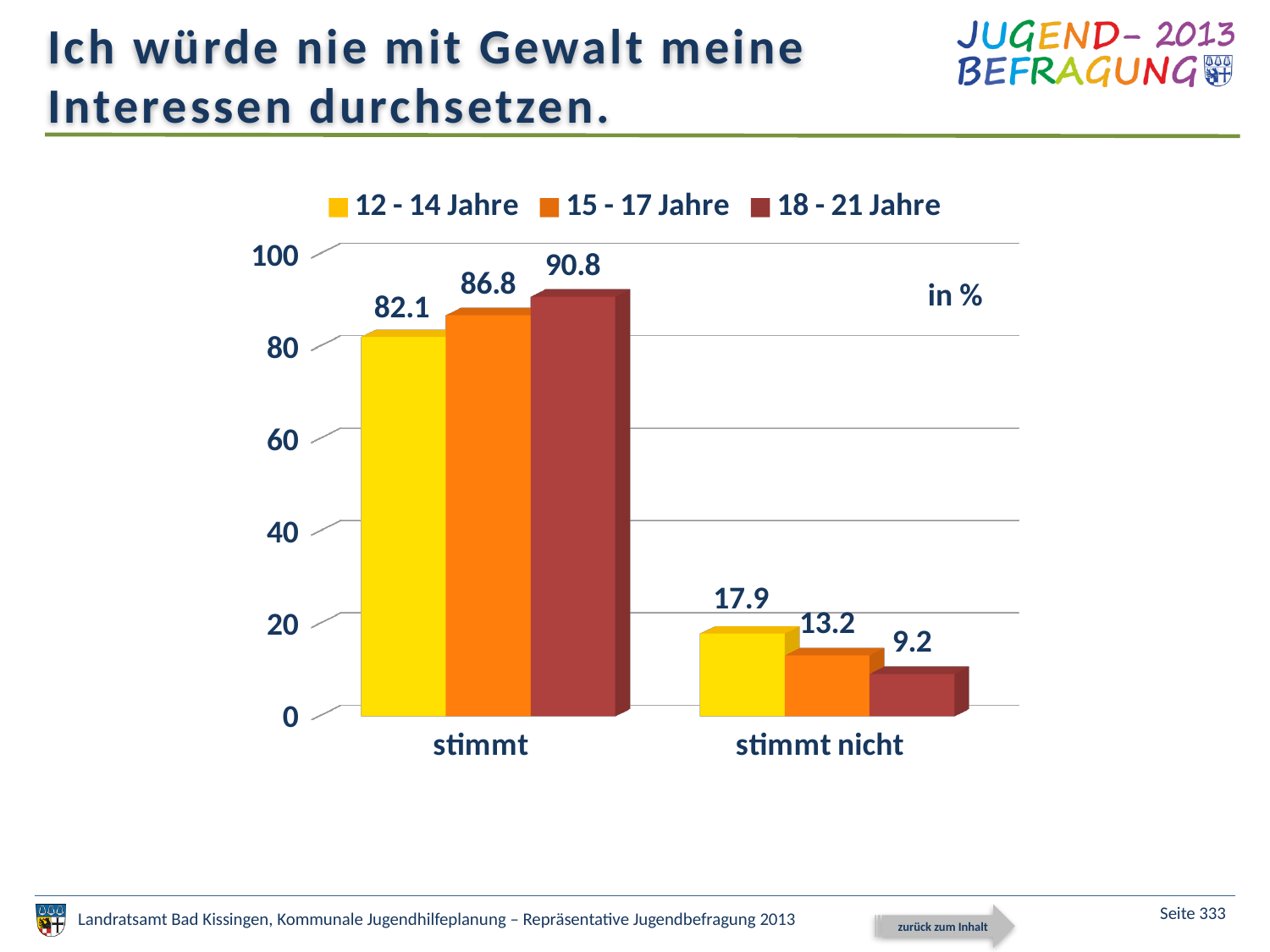
What is the difference between the 18 - 21 Jahre and 12 - 14 Jahre values in the "stimmt" category? 8.7 What is the difference between the 12 - 14 Jahre and 15 - 17 Jahre values in the "stimmt nicht" category? 4.7 What kind of chart is shown on the slide? bar chart Which age group has the highest value in the "stimmt" category? 18 - 21 Jahre What is the value for the 15 - 17 Jahre series in the "stimmt" category? 86.8 What is the value for the 18 - 21 Jahre series in the "stimmt nicht" category? 9.2 Which age group has the lowest value in the "stimmt nicht" category? 18 - 21 Jahre How many categories are shown on the x axis? 2 How many series does the legend list? 3 In the "stimmt nicht" category, which is larger: the value for 12 - 14 Jahre or for 15 - 17 Jahre? 12 - 14 Jahre Is the value for 15 - 17 Jahre in the "stimmt nicht" category greater or less than 20? less What is the value for the 12 - 14 Jahre series in the "stimmt" category? 82.1